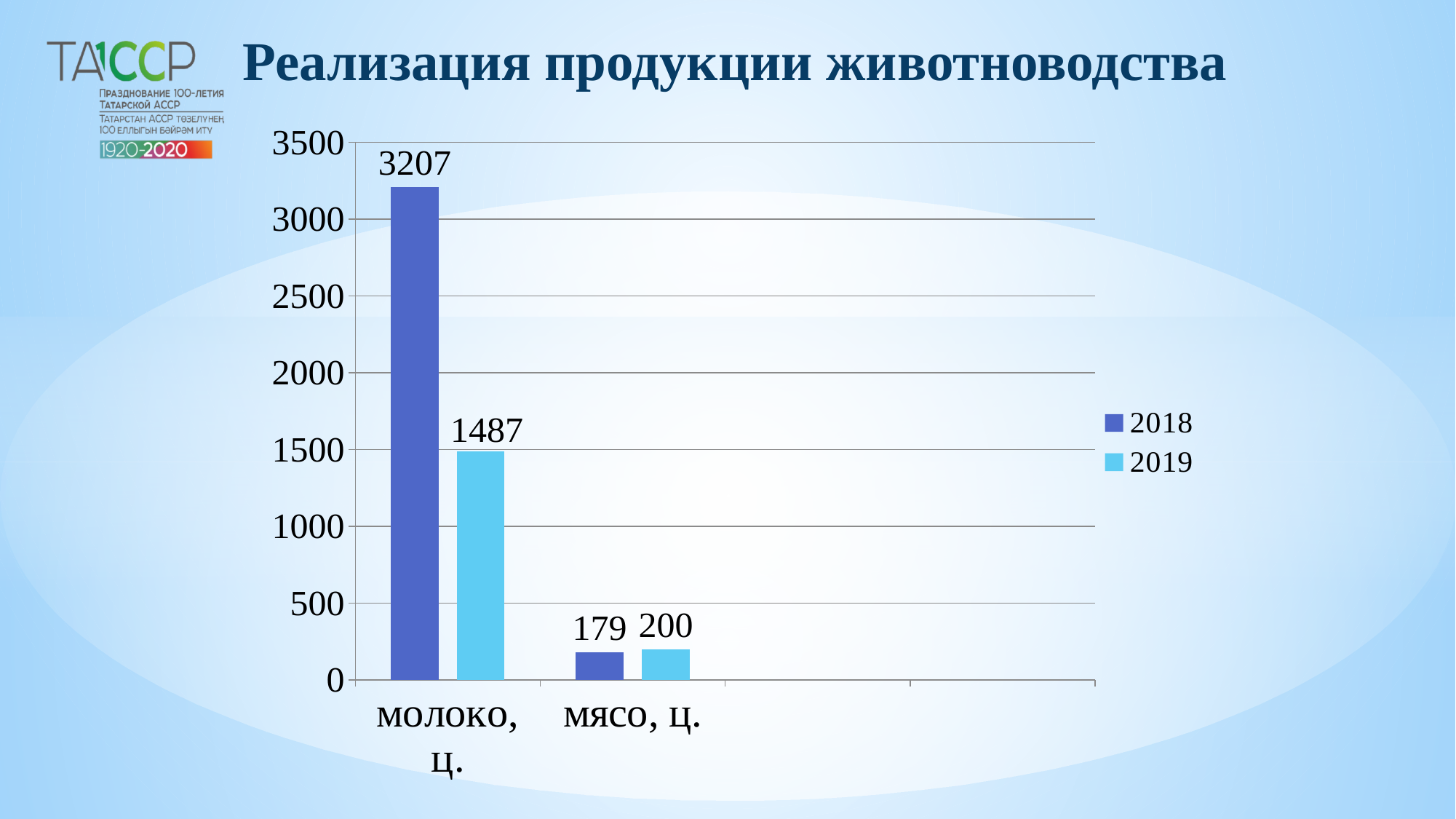
Which is larger for мясо, ц.: the 2018 value or the 2019 value? 2019 What is the value for мясо, ц. in 2018? 179 What is the value for молоко, ц. in 2018? 3207 What is the value for молоко, ц. in 2019? 1487 What is the difference between the 2018 and 2019 values for молоко, ц.? 1720 Which category has the highest value in the 2018 series? молоко, ц. How many categories are shown on the x axis? 2 What is the difference between the 2019 and 2018 values for мясо, ц.? 21 Which category has the lowest value in the 2019 series? мясо, ц. What kind of chart is shown on the slide? bar chart What is the value for мясо, ц. in 2019? 200 How many series does the legend list? 2